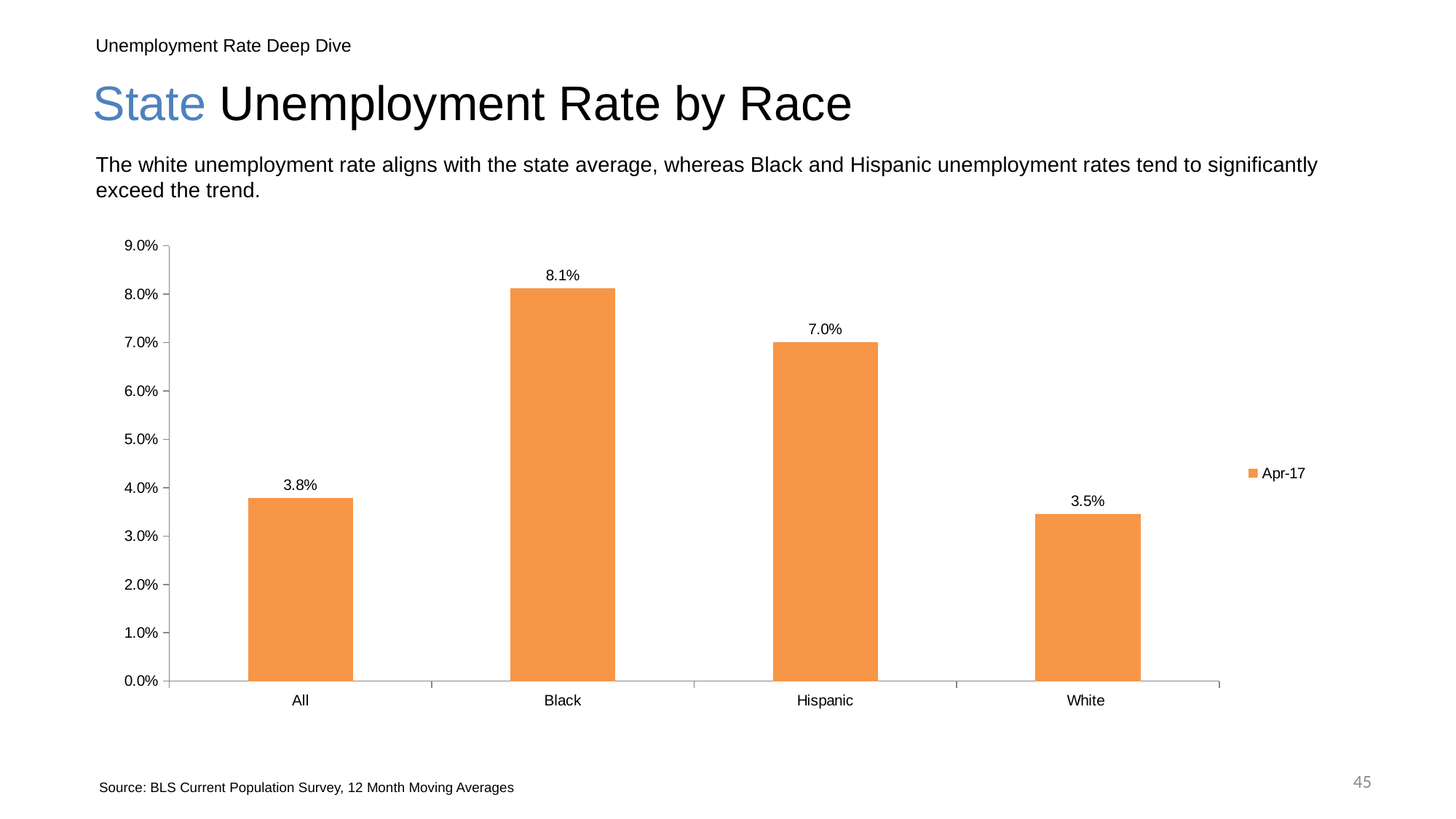
What is the unemployment rate for Hispanic? 7.0% What series does the legend list? Apr-17 How many categories are shown on the x axis? 4 What is the unemployment rate for White? 3.5% What kind of chart is shown on the slide? Bar chart Which category has the lowest unemployment rate? White Which is larger, the unemployment rate for Hispanic or for All? Hispanic What is the unemployment rate for All? 3.8% What is the unemployment rate for Black? 8.1% What is the difference between the Black and White unemployment rates? 4.6% What is the difference between the Black and Hispanic unemployment rates? 1.1% Which category has the highest unemployment rate? Black